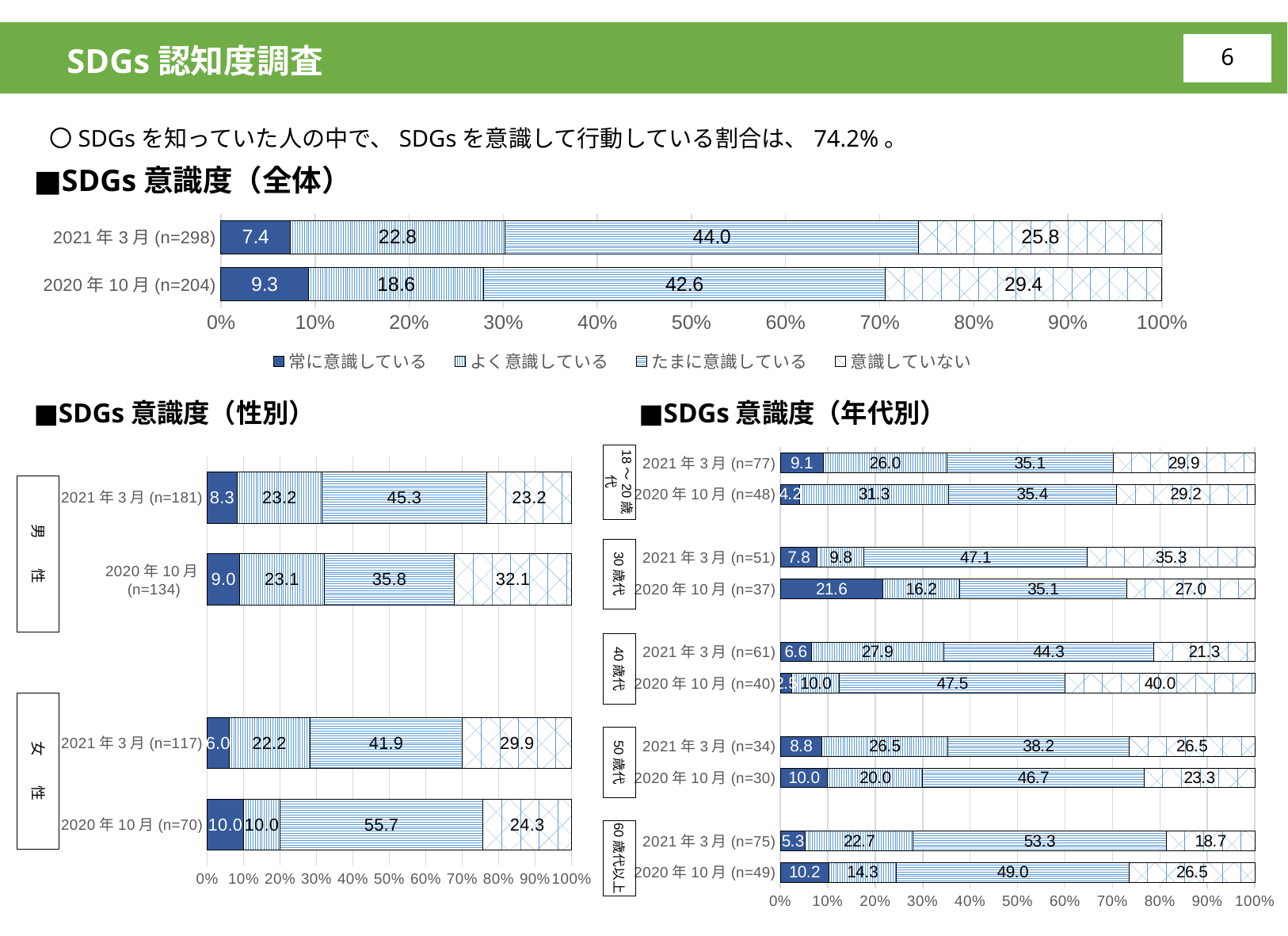
In the SDGs意識度（年代別） chart, which bar has the lowest 常に意識している value? 40歳代 2020年10月 (n=40) In the SDGs意識度（全体） chart, how many series does the legend list? 4 In the SDGs意識度（全体） chart, what is the value of 意識していない for 2020年10月 (n=204)? 29.4 What kind of chart is the SDGs意識度（性別） chart? Stacked bar chart In the SDGs意識度（全体） chart, what is the value of たまに意識している for 2021年3月 (n=298)? 44.0 In the SDGs意識度（性別） chart, what is the value of たまに意識している for 女性 2020年10月 (n=70)? 55.7 In the SDGs意識度（年代別） chart, what is the value of 常に意識している for 30歳代 2020年10月 (n=37)? 21.6 In the SDGs意識度（年代別） chart, which bar has the highest 意識していない value? 40歳代 2020年10月 (n=40) In the SDGs意識度（性別） chart, which is larger: the 意識していない value for 男性 2020年10月 (n=134) or for 男性 2021年3月 (n=181)? 男性 2020年10月 (n=134) In the SDGs意識度（性別） chart, how many bars are plotted? 4 In the SDGs意識度（全体） chart, what is the difference between the よく意識している values for 2021年3月 (n=298) and 2020年10月 (n=204)? 4.2 In the SDGs意識度（年代別） chart, what is the value of たまに意識している for 60歳代以上 2021年3月 (n=75)? 53.3